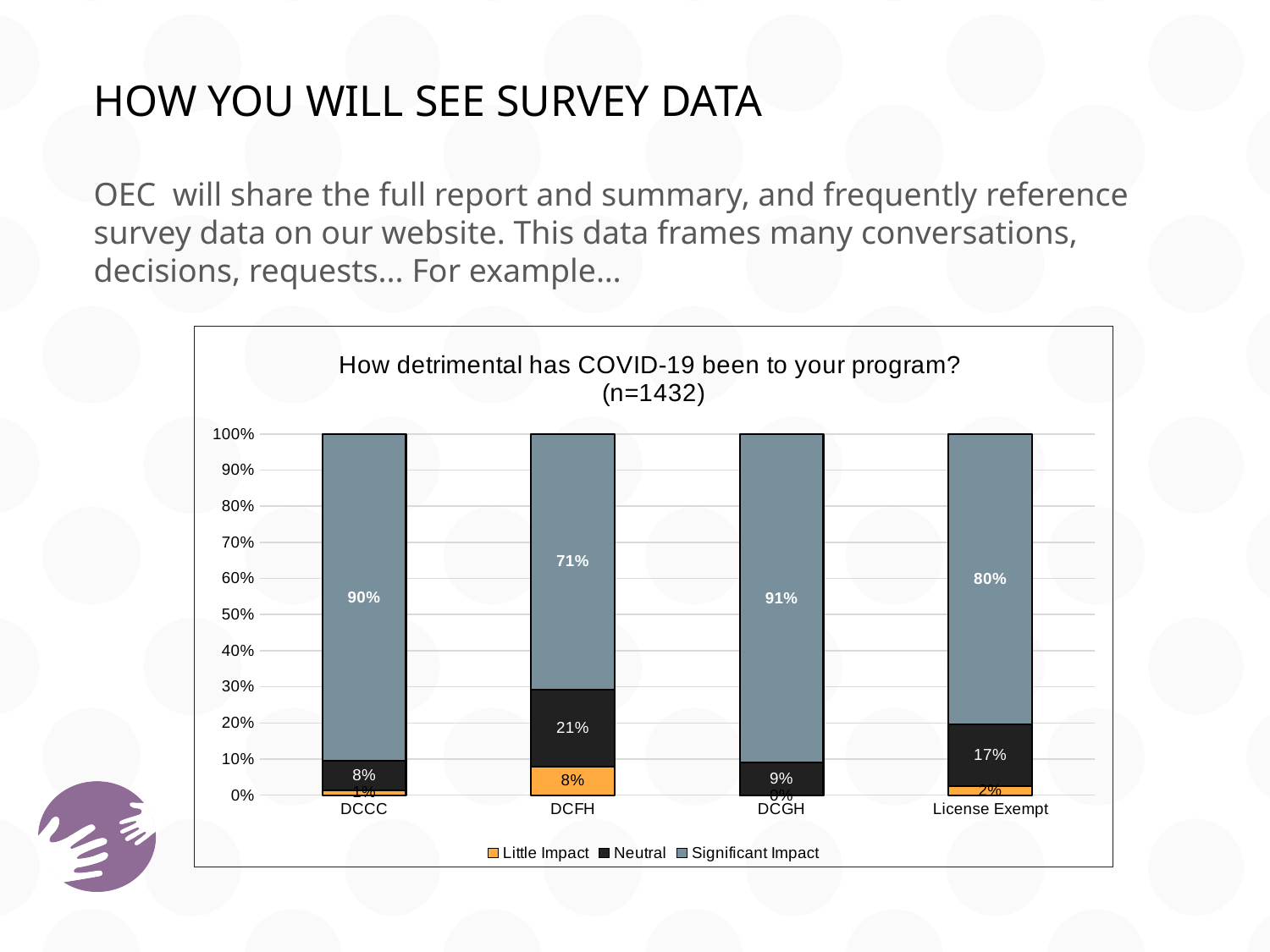
What is the Little Impact value for DCFH? 8% How many categories are shown on the x axis? 4 What percentage of DCFH respondents reported Significant Impact? 71% Which has a larger Neutral value, DCCC or DCGH? DCGH What is the difference between the Significant Impact values for DCGH and DCFH? 20 percentage points How many series does the legend list? 3 Which category has the highest Significant Impact percentage? DCGH Which category has the highest Neutral percentage? DCFH Which category has the lowest Significant Impact percentage? DCFH What is the Neutral value for License Exempt? 17% What is the Significant Impact value for License Exempt? 80% What kind of chart is shown on the slide? Stacked bar chart